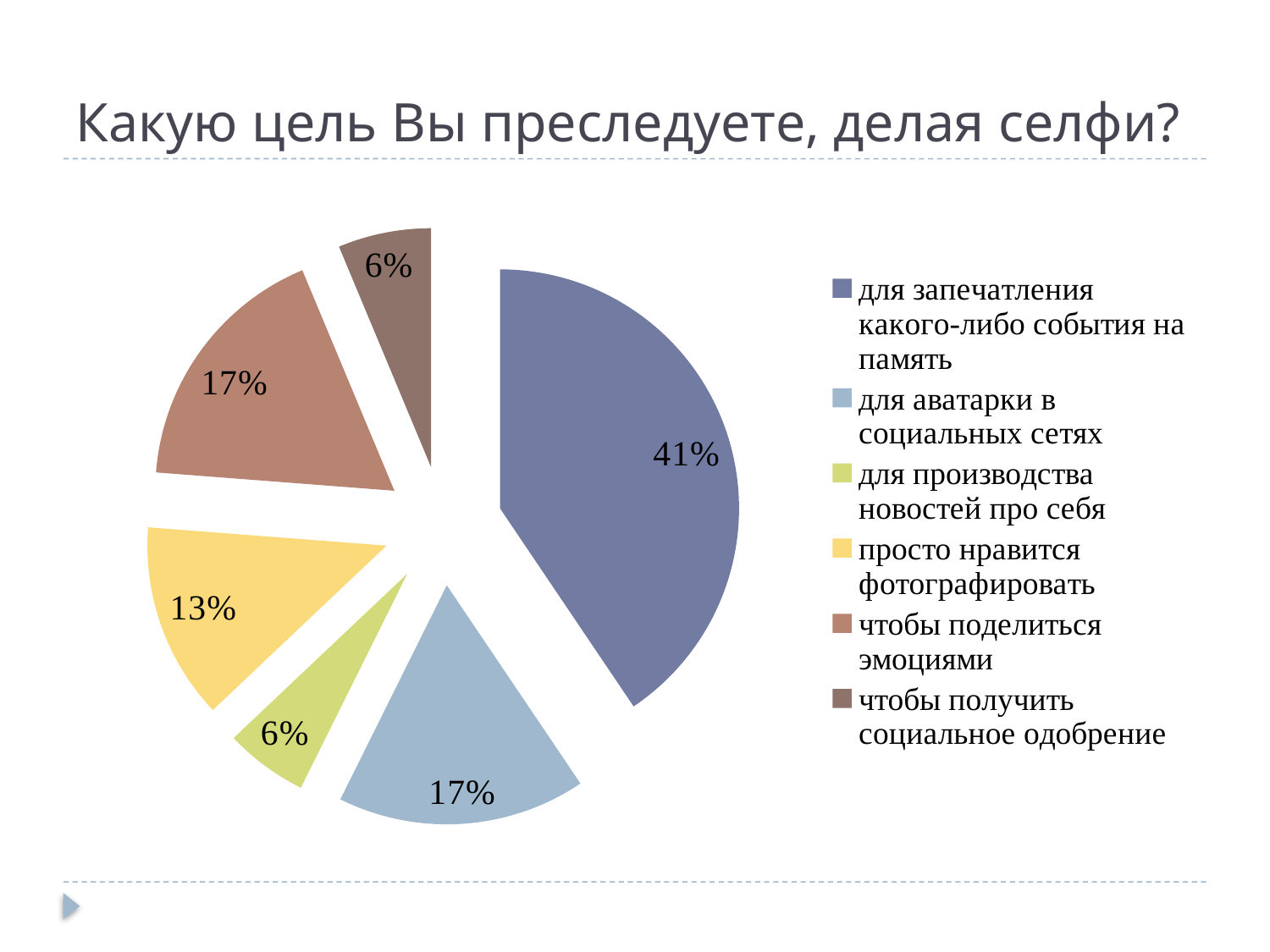
What is the title of the chart? Какую цель Вы преследуете, делая селфи? What is the difference in percentage points between the share for 'для запечатления какого-либо события на память' and the share for 'для аватарки в социальных сетях'? 24 How many slices does the pie chart have? 6 Which category has the largest share of the pie? для запечатления какого-либо события на память What share of the pie is 'для запечатления какого-либо события на память'? 41% Which colour is used for the 'для производства новостей про себя' slice? green What share of the pie is 'чтобы поделиться эмоциями'? 17% What share of the pie is 'для аватарки в социальных сетях'? 17% Which is larger: the share for 'просто нравится фотографировать' or the share for 'чтобы поделиться эмоциями'? чтобы поделиться эмоциями What kind of chart is shown on the slide? pie chart